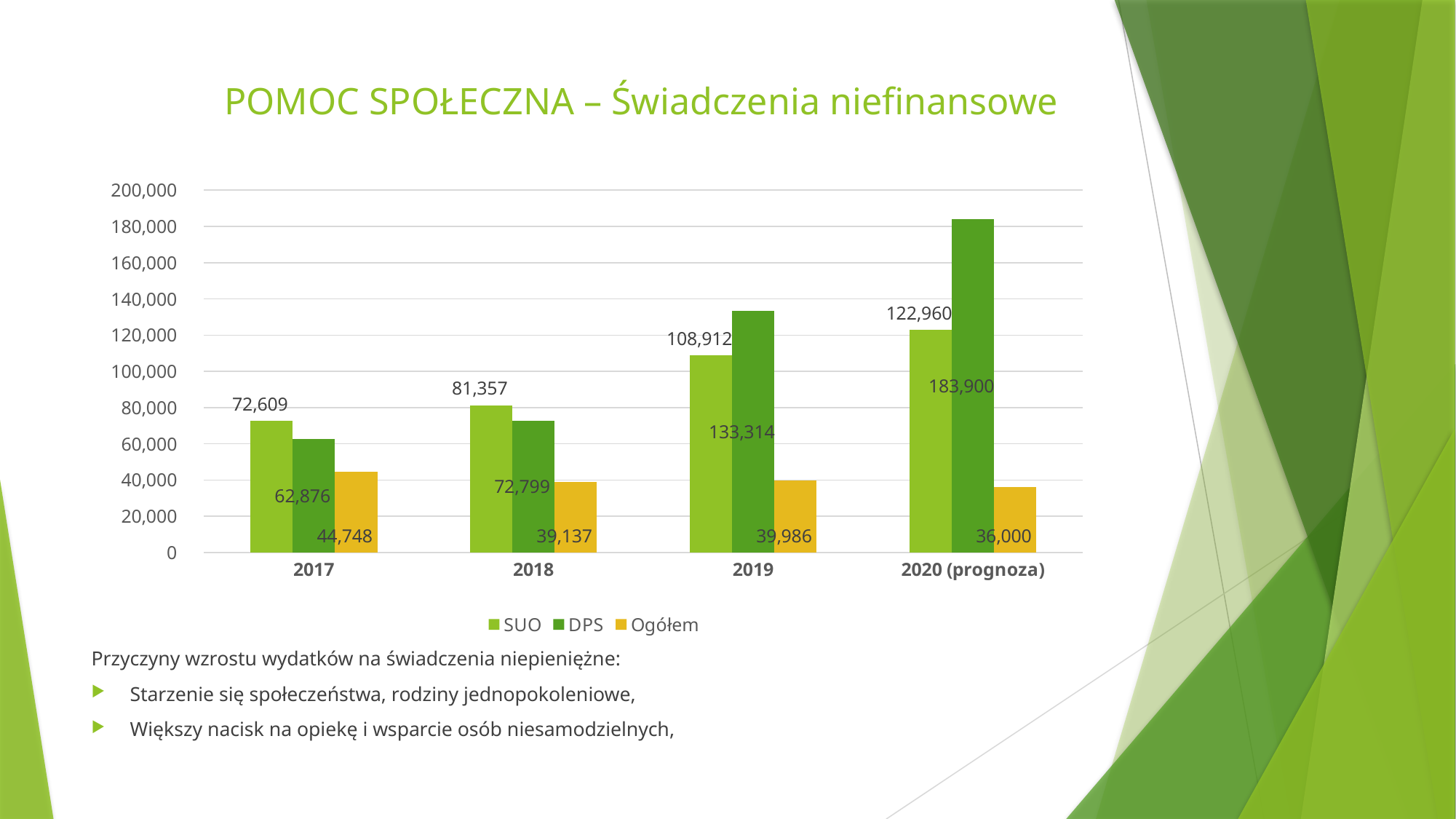
In which year is the Ogółem value lowest? 2020 (prognoza) Which is larger in 2018, SUO or DPS? SUO What kind of chart is shown on the slide? bar chart In which year is the DPS value highest? 2020 (prognoza) How many years (categories) are shown on the x axis? 4 What is the value for DPS in 2020 (prognoza)? 183,900 What is the difference between the DPS and SUO values in 2020 (prognoza)? 60,940 What is the value for Ogółem in 2018? 39,137 What is the value for SUO in 2017? 72,609 What is the value for DPS in 2019? 133,314 How many series does the legend list? 3 Does the SUO value rise or fall from 2017 to 2020 (prognoza)? rise